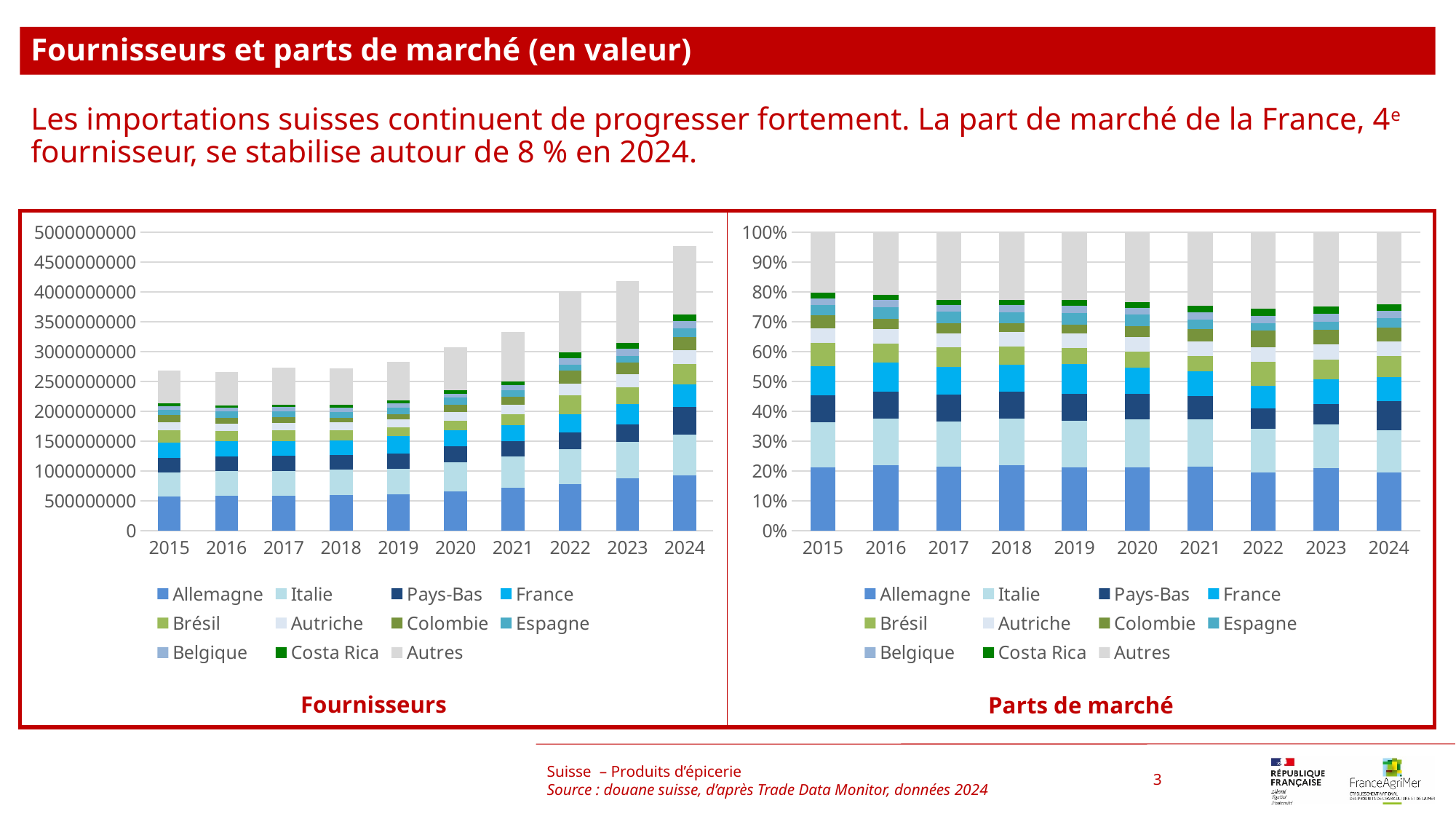
In the 'Fournisseurs' chart, is the total bar for 2024 larger or smaller than the total bar for 2021? larger In the 'Fournisseurs' chart, which year has the highest total bar? 2024 How many years are shown on the x axis of the 'Parts de marché' chart? 10 In the 'Fournisseurs' chart, is the total for 2015 greater or less than 3000000000? less What kind of chart is the 'Fournisseurs' chart on the left? Stacked bar chart Which series is plotted at the bottom of each stacked bar in both charts? Allemagne In the 'Fournisseurs' chart, do the total bars generally rise or fall from 2019 to 2024? rise In the 'Fournisseurs' chart, is the total for 2024 greater or less than 4500000000? greater What is the title of the chart on the right side of the slide? Parts de marché In the 'Fournisseurs' chart, is the total for 2021 greater or less than 3000000000? greater How many series does the legend of the 'Fournisseurs' chart list? 11